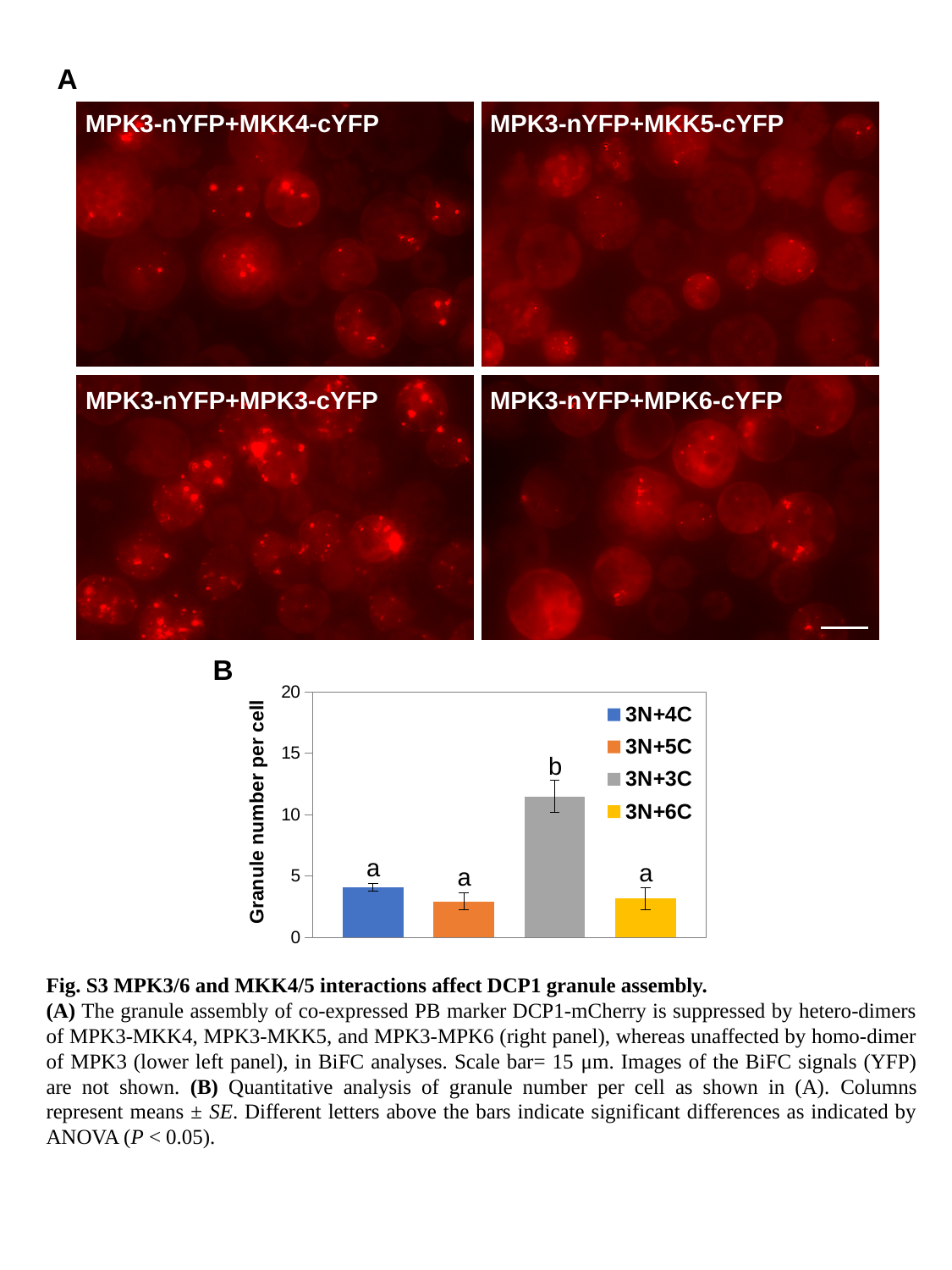
In the chart in panel B, which series is shown in gray? 3N+3C In the chart in panel B, is the value for 3N+5C greater or less than 5? less In the chart in panel B, is the value for 3N+3C greater or less than 10? greater What is the y-axis title of the chart in panel B? Granule number per cell How many bars are plotted in the chart in panel B? 4 In the chart in panel B, which is larger, the value for 3N+3C or the value for 3N+4C? 3N+3C In the chart in panel B, is the value for 3N+3C greater or less than 15? less In the chart in panel B, which is larger, the value for 3N+4C or the value for 3N+5C? 3N+4C In the chart in panel B, which series has the highest granule number per cell? 3N+3C How many series does the legend of the chart in panel B list? 4 What kind of chart is shown in panel B? bar chart